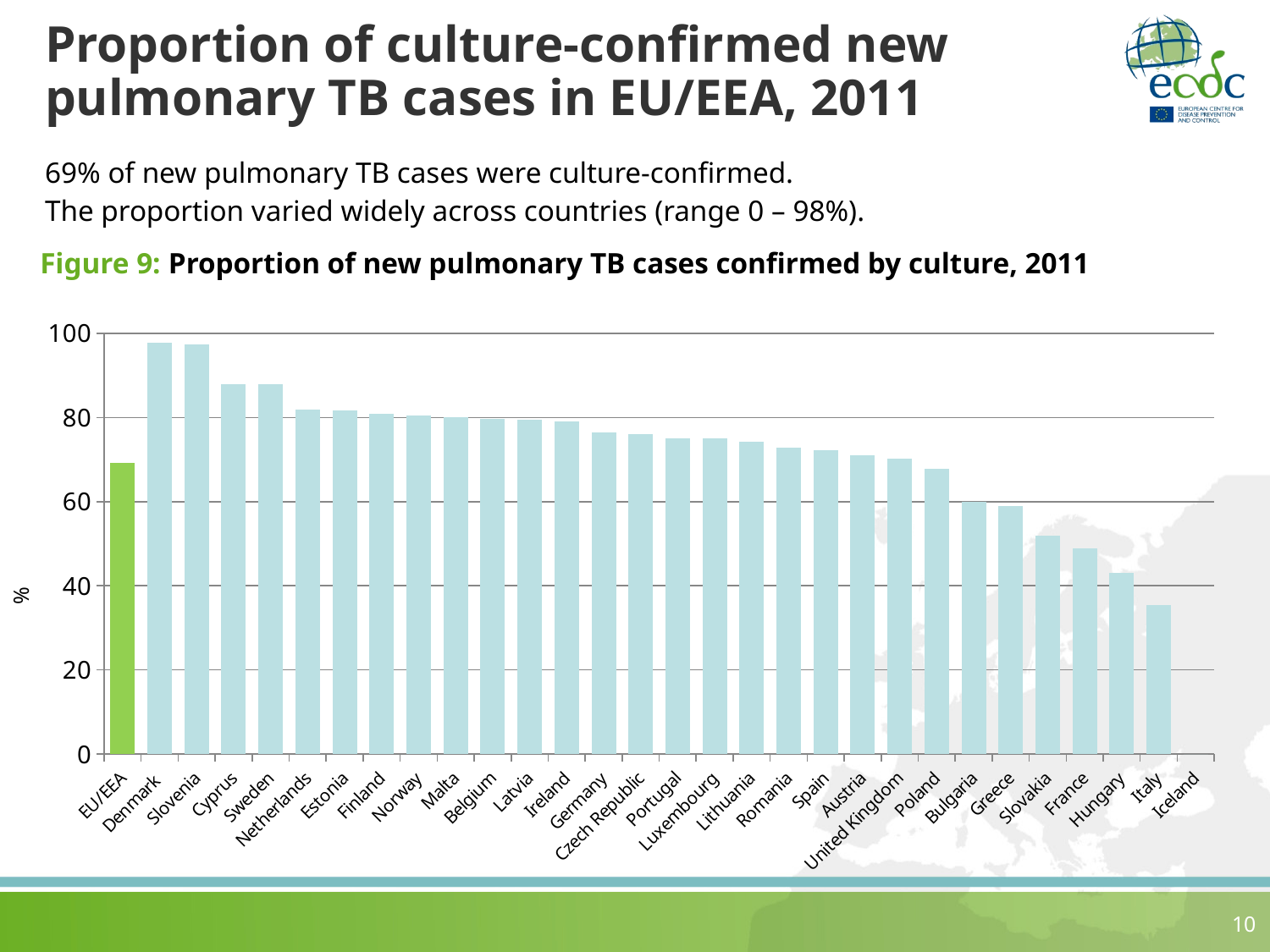
What is the proportion of culture-confirmed new pulmonary TB cases for EU/EEA in Figure 9? 69% What colour is the EU/EEA bar in Figure 9? green How many bars (categories) are plotted in Figure 9? 30 Is the value for Italy in Figure 9 greater or less than 40? less Which category has the lowest proportion of culture-confirmed new pulmonary TB cases in Figure 9? Iceland Is the value for Poland in Figure 9 greater or less than 60? greater Is the value for Cyprus in Figure 9 greater or less than 80? greater Moving from Denmark to Iceland along the x axis in Figure 9, do the values rise or fall? fall What kind of chart is shown in Figure 9? bar chart In Figure 9, which has the larger value, Sweden or Poland? Sweden